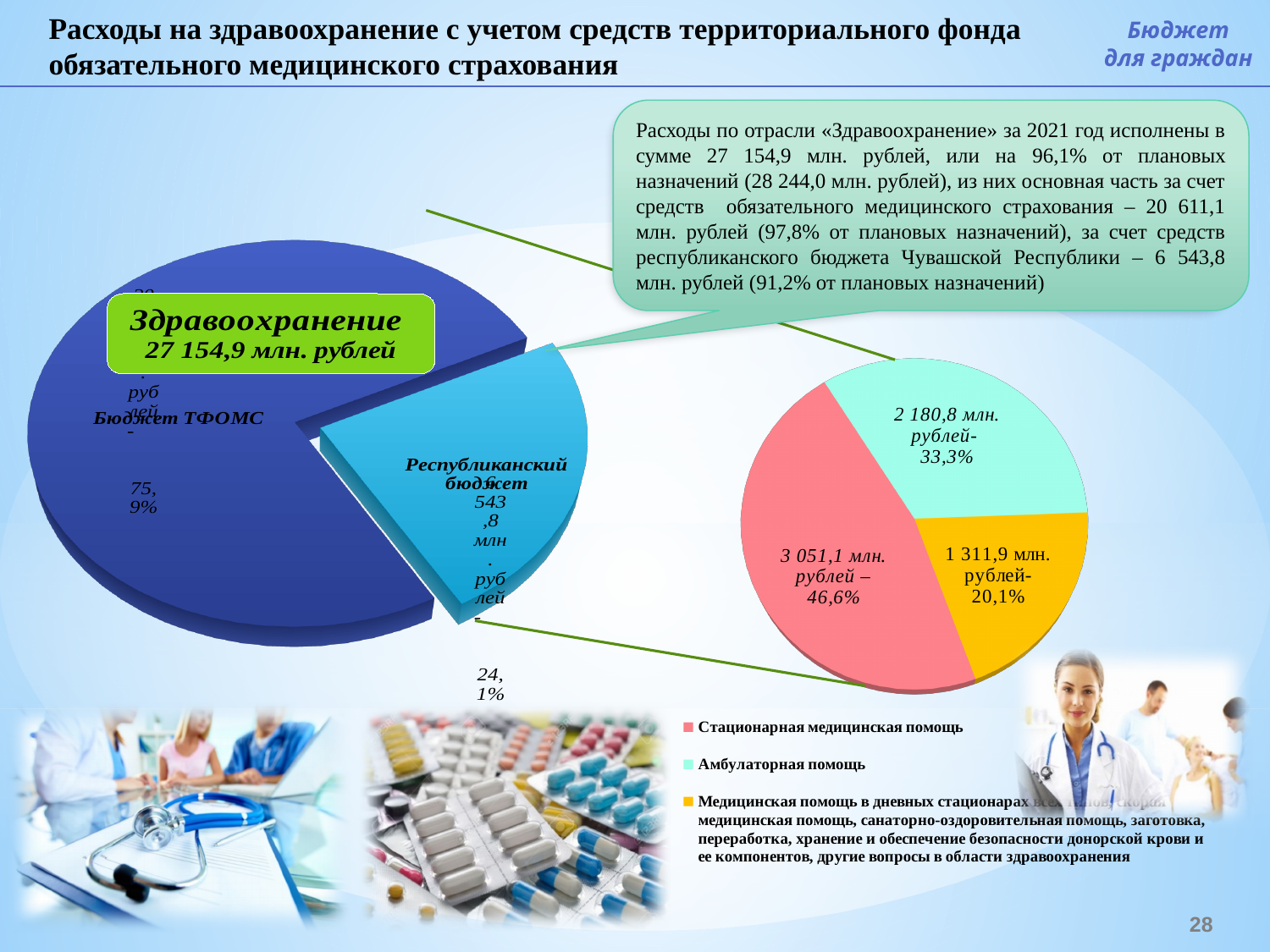
In the right pie chart, what value is shown for the yellow slice (Медицинская помощь в дневных стационарах ...)? 1 311,9 млн. рублей In the right pie chart, what is the difference in share between Стационарная медицинская помощь and Амбулаторная помощь? 13,3% In the right pie chart, which category has the largest slice? Стационарная медицинская помощь In the left pie chart, what share does Республиканский бюджет have? 24,1% In the left pie chart, what share does Бюджет ТФОМС have? 75,9% In the right pie chart, what share does Стационарная медицинская помощь have? 46,6% How many charts are on the slide? 2 In the left pie chart, which slice is larger: Бюджет ТФОМС or Республиканский бюджет? Бюджет ТФОМС In the right pie chart, what value is shown for Амбулаторная помощь? 2 180,8 млн. рублей In the right pie chart, how many slices are there? 3 What kind of chart is the chart on the right side of the slide? Pie chart